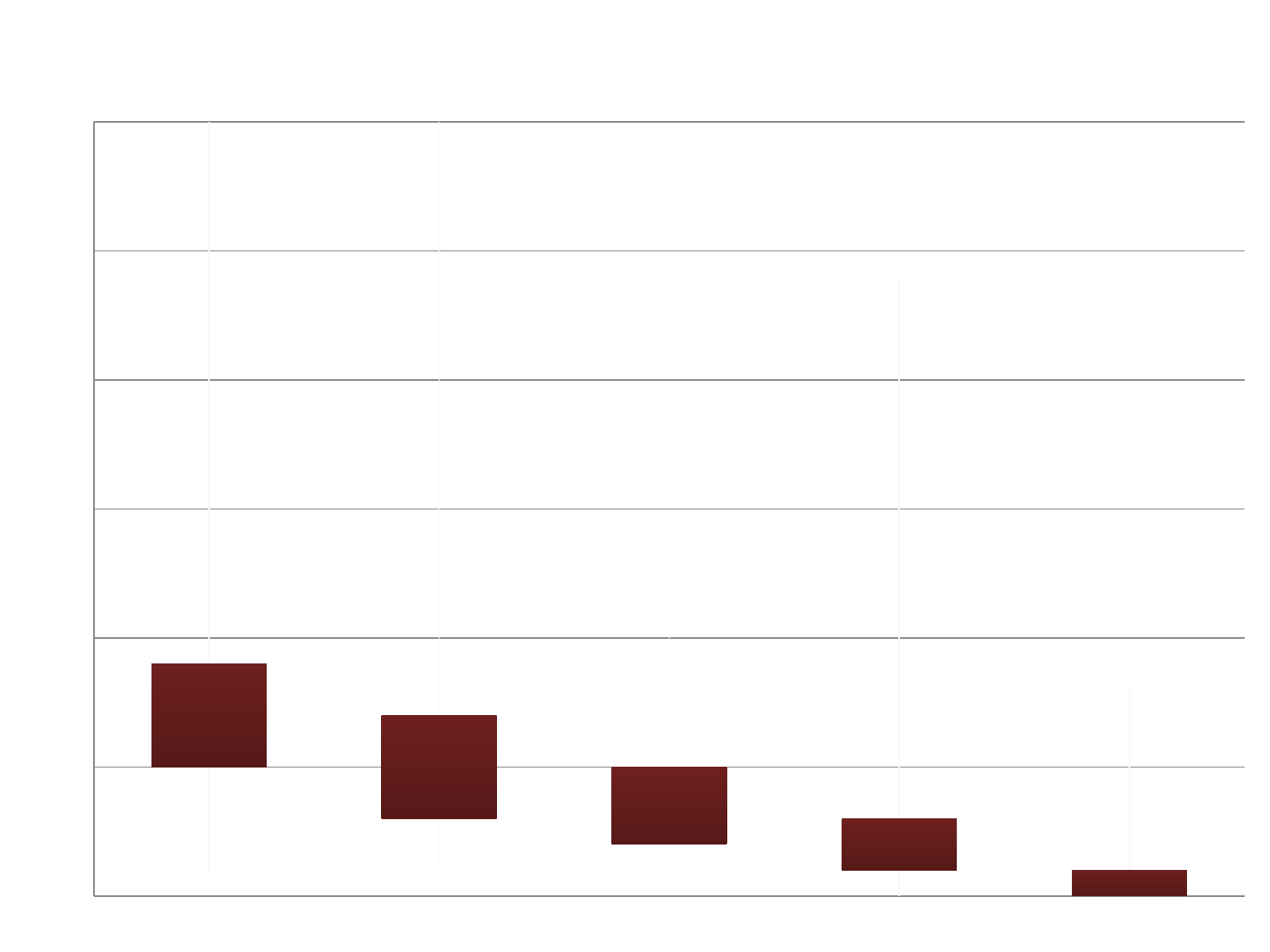
What kind of chart is shown on the slide? stock chart How many bars are plotted on the chart? 5 Which bar sits lowest on the chart, the leftmost or the rightmost? rightmost Does the chart display a legend? No What colour are the bars on the chart? dark red Which bar reaches higher, the second bar from the left or the fourth bar from the left? second bar from the left Which bar reaches the highest point on the chart, the leftmost or the rightmost? leftmost Do the bars rise or fall moving from left to right across the chart? fall